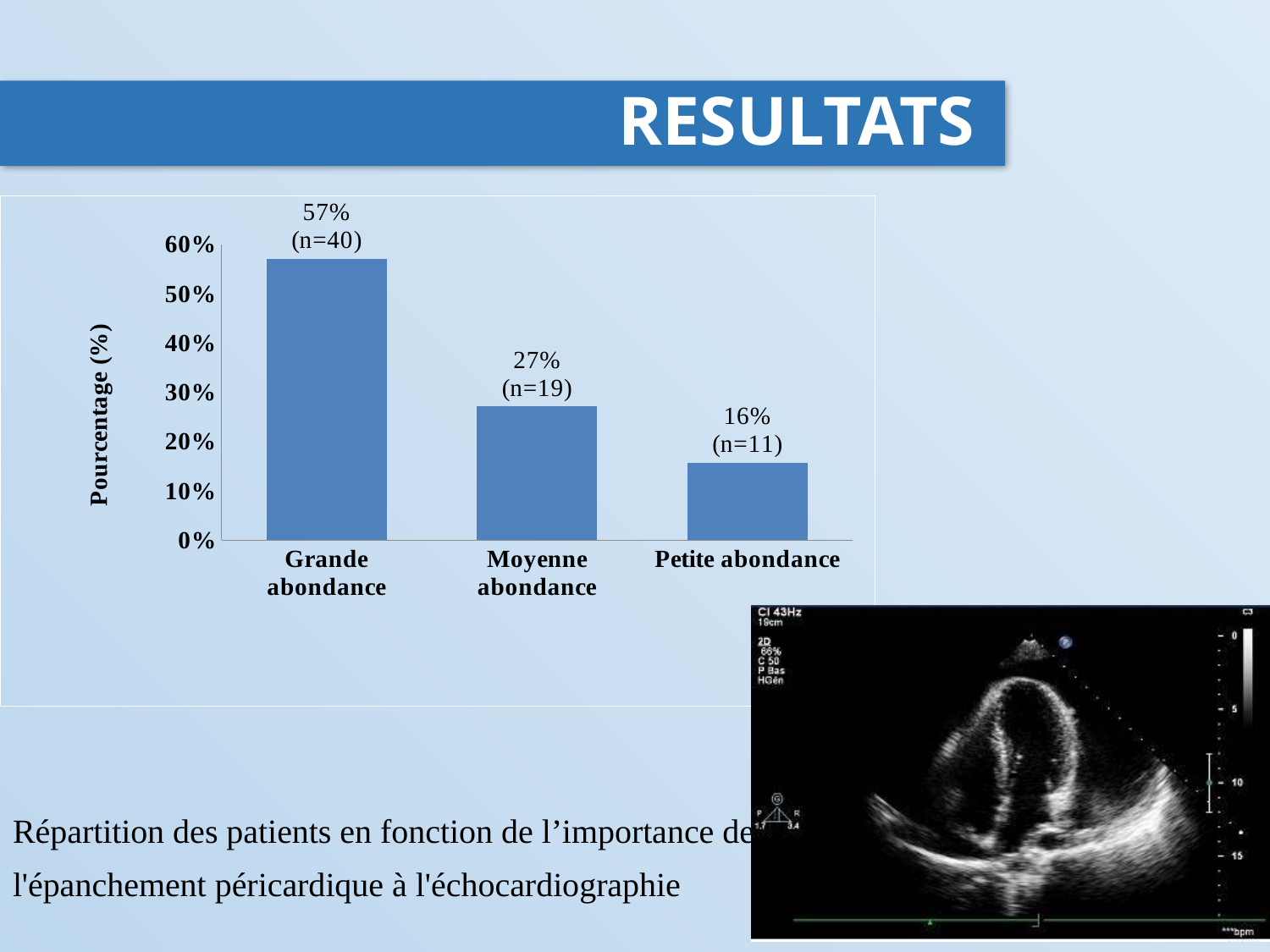
What is the difference in percentage between Grande abondance and Petite abondance? 41% What percentage is shown for Moyenne abondance? 27% How many patients (n) are in the Moyenne abondance category? n=19 Which is larger, the percentage for Moyenne abondance or for Petite abondance? Moyenne abondance How many categories are shown on the x axis? 3 What percentage is shown for Grande abondance? 57% What kind of chart is shown on the slide? bar chart What is the label of the y axis? Pourcentage (%) What percentage is shown for Petite abondance? 16% Is the value for Moyenne abondance greater or less than 30%? less Which category has the highest percentage? Grande abondance Which category has the lowest percentage? Petite abondance